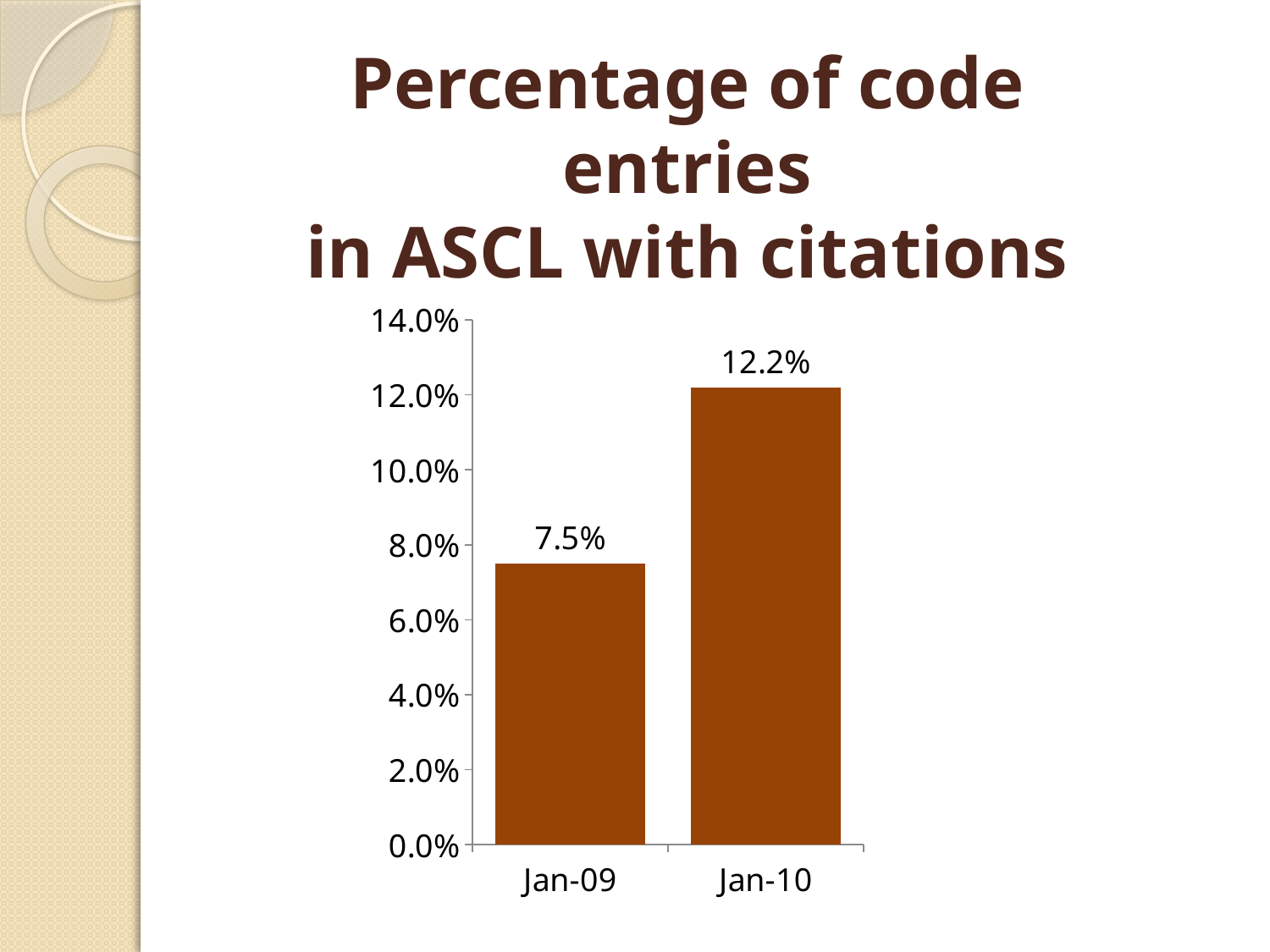
Is the value for Jan-10 greater or less than 10.0%? greater Which category has the lowest value? Jan-09 Is the value for Jan-09 greater or less than 8.0%? less What is the title of the slide? Percentage of code entries in ASCL with citations Do the values rise or fall from Jan-09 to Jan-10? rise What is the value for Jan-09? 7.5% Which is larger, the value for Jan-09 or the value for Jan-10? Jan-10 What is the value for Jan-10? 12.2% What kind of chart is shown on the slide? bar chart How many categories are shown on the x axis? 2 What is the difference between the values for Jan-10 and Jan-09? 4.7% Which category has the highest value? Jan-10